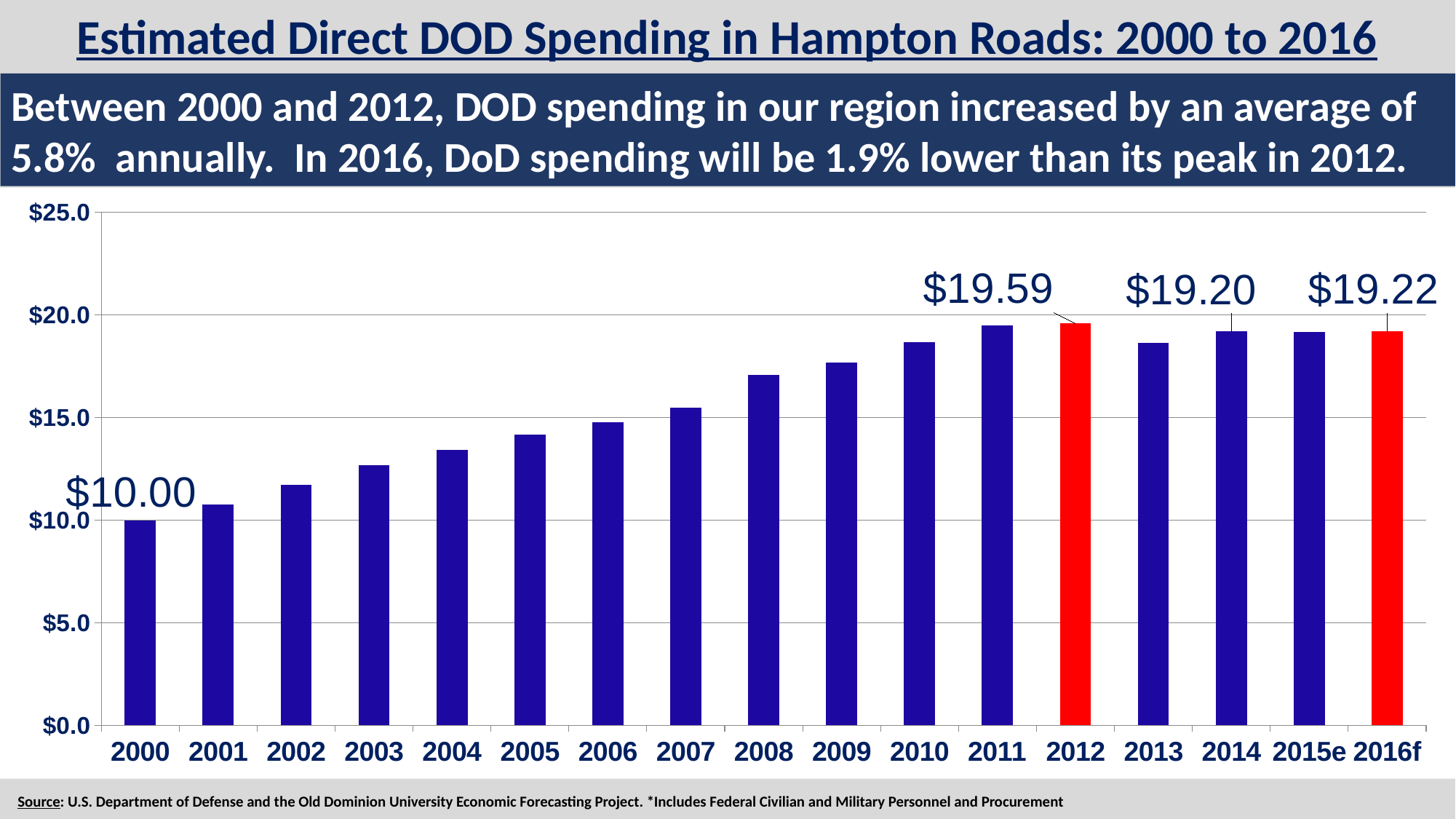
What is the value for 2000? $10.00 What kind of chart is shown on the slide? bar chart Is the value for 2005 greater or less than $15.0? less How many bars are shown in the chart? 17 Which year has the highest value? 2012 What is the value for 2016f? $19.22 What is the difference between the values for 2012 and 2016f? $0.37 Which is larger, the value for 2012 or the value for 2013? 2012 What is the value for 2012? $19.59 Which year has the lowest value? 2000 Is the value for 2008 greater or less than $15.0? greater What is the difference between the values for 2012 and 2000? $9.59